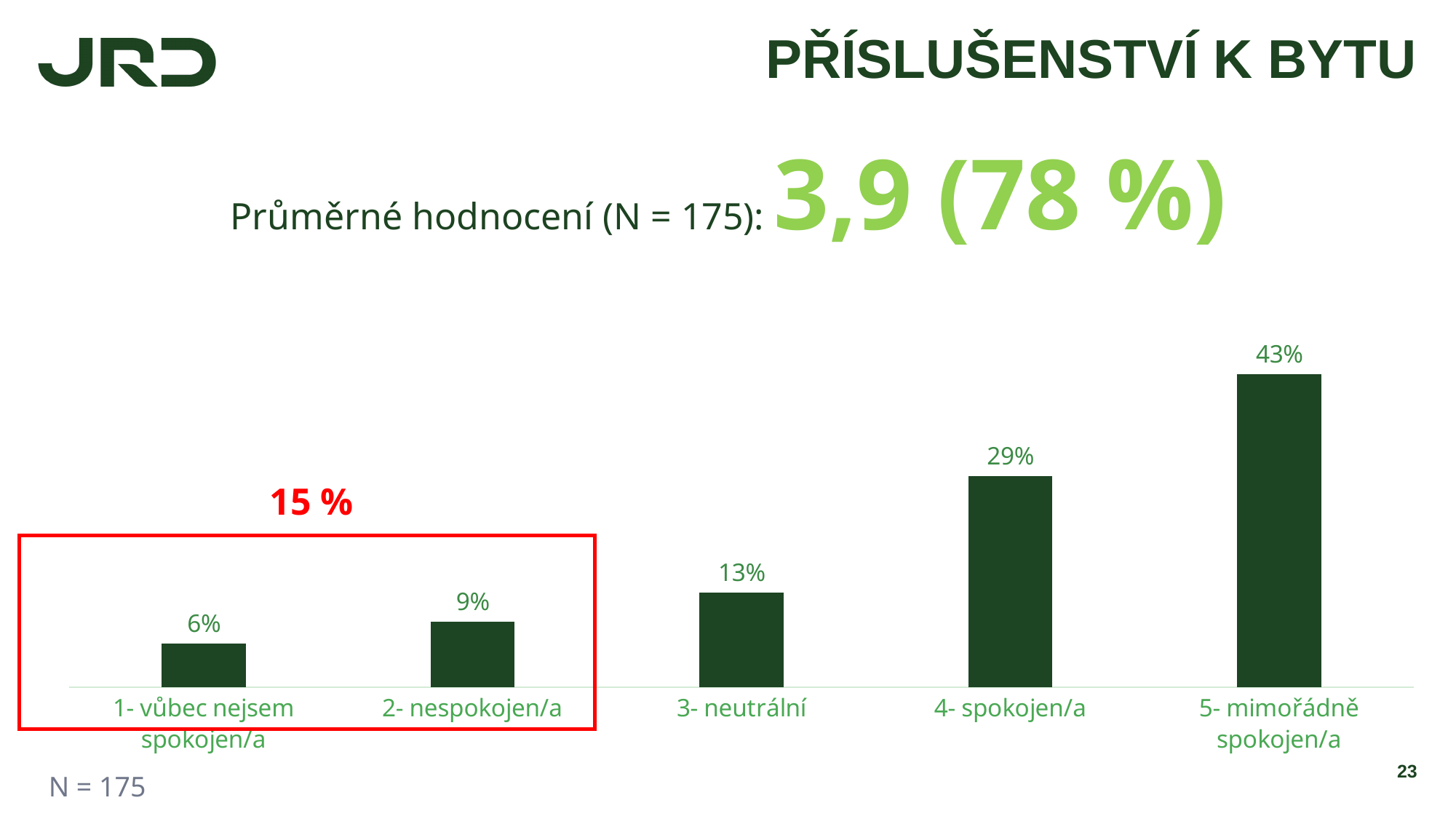
What kind of chart is shown on the slide? bar chart Which category has the lowest value? 1- vůbec nejsem spokojen/a What is the value for "1- vůbec nejsem spokojen/a"? 6% Do the values rise or fall from left to right along the x axis? rise What is the value for "5- mimořádně spokojen/a"? 43% What average rating is shown above the chart? 3,9 (78 %) Which is larger, the value for "2- nespokojen/a" or the value for "3- neutrální"? 3- neutrální Which category has the highest value? 5- mimořádně spokojen/a What is the value for "3- neutrální"? 13% What is the combined value of the two categories inside the red box? 15 % What is the difference between the values for "4- spokojen/a" and "3- neutrální"? 16% How many categories are shown on the x axis? 5